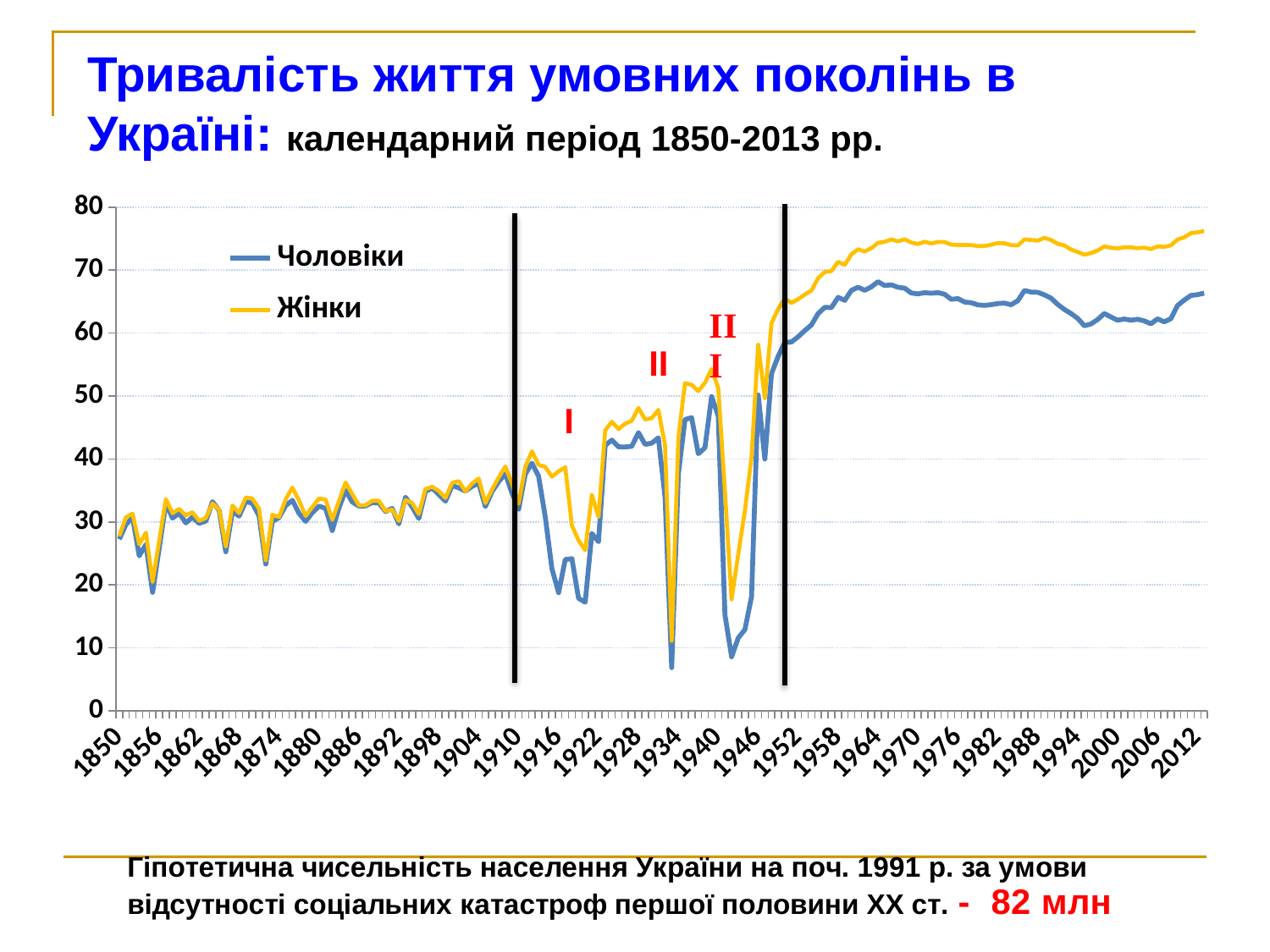
Between 1952 and 1964, do the values for Чоловіки rise or fall? rise What kind of chart is shown on the slide? line chart What calendar period does the chart title say it covers? 1850-2013 рр. How many series does the legend list? 2 Is the value for Жінки in 2012 greater or less than 70? greater Which is larger for Чоловіки, the value in 1850 or the value in 2012? 2012 Is the value for Чоловіки in 1850 greater or less than 40? less Which series has the higher value in 2012, Чоловіки or Жінки? Жінки What are the two series named in the legend? Чоловіки and Жінки Is the value for Жінки in 1850 greater or less than 40? less